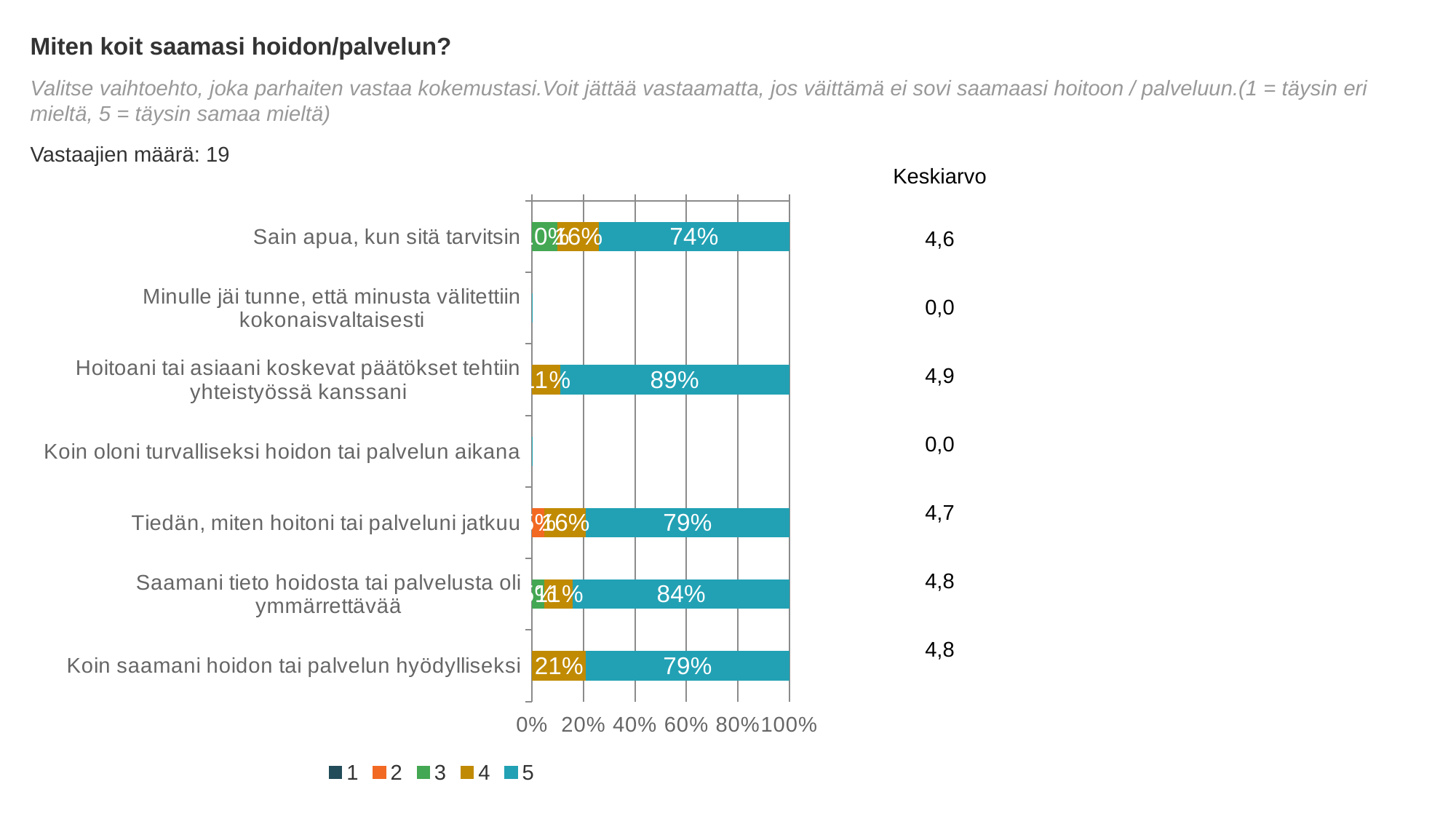
What is the total of the stacked bar for "Koin saamani hoidon tai palvelun hyödylliseksi" (4 and 5 segments)? 100% What percentage of respondents gave a 5 for "Sain apua, kun sitä tarvitsin"? 74% How many series does the legend list? 5 What is the Keskiarvo value for "Tiedän, miten hoitoni tai palveluni jatkuu"? 4,7 What is the Keskiarvo value for "Koin oloni turvalliseksi hoidon tai palvelun aikana"? 0,0 Which is larger: the share of 5 answers for "Saamani tieto hoidosta tai palvelusta oli ymmärrettävää" or for "Sain apua, kun sitä tarvitsin"? Saamani tieto hoidosta tai palvelusta oli ymmärrettävää How many statement categories are listed on the chart's vertical axis? 7 What percentage of respondents gave a 4 for "Koin saamani hoidon tai palvelun hyödylliseksi"? 21% What percentage of respondents gave a 5 for "Hoitoani tai asiaani koskevat päätökset tehtiin yhteistyössä kanssani"? 89% What is the difference in percentage points between the share of 5 answers for "Hoitoani tai asiaani koskevat päätökset tehtiin yhteistyössä kanssani" and for "Sain apua, kun sitä tarvitsin"? 15 Which statement has the highest share of respondents answering 5? Hoitoani tai asiaani koskevat päätökset tehtiin yhteistyössä kanssani What kind of chart is shown on the slide? bar chart